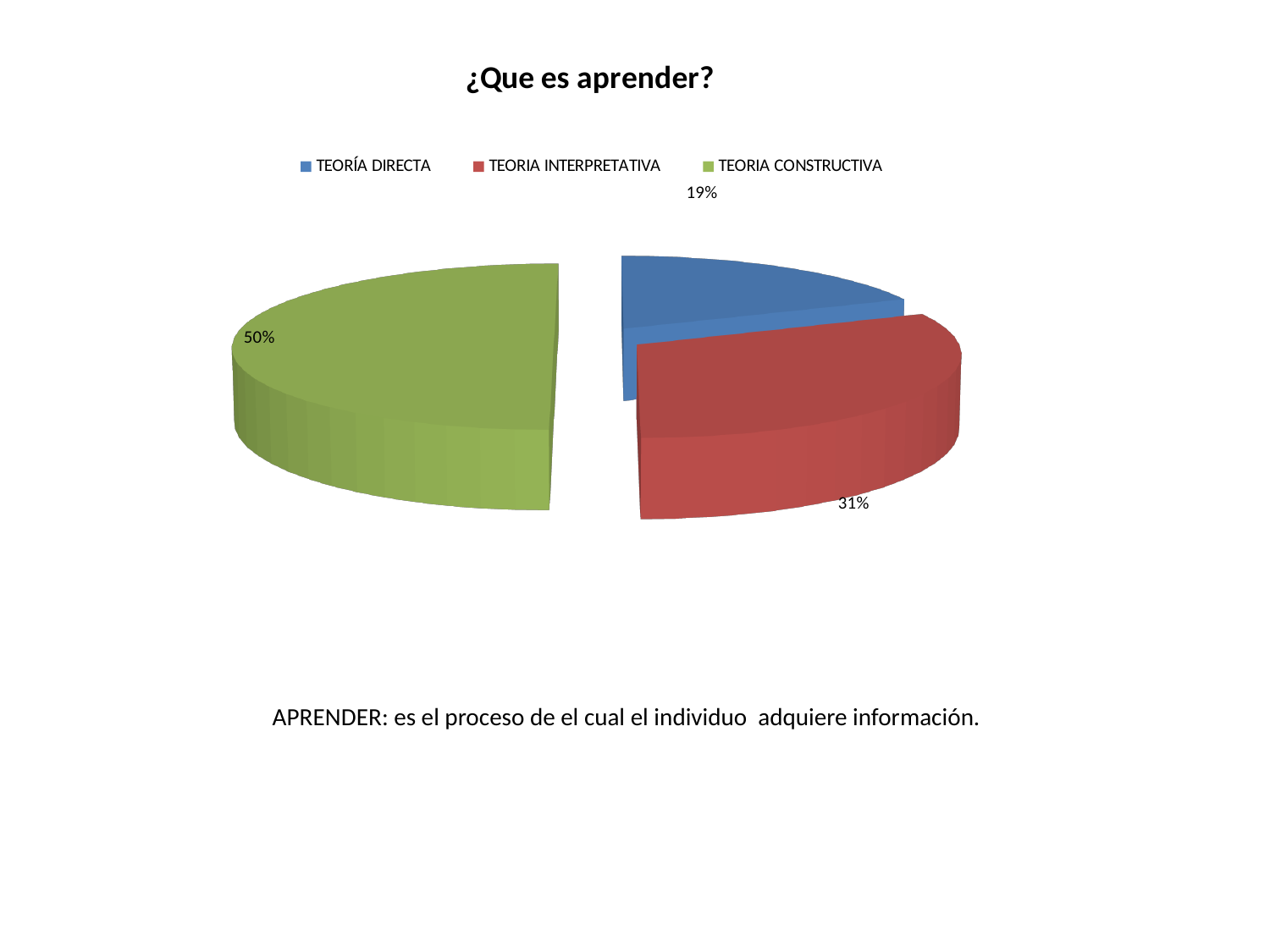
What percentage is shown for TEORIA CONSTRUCTIVA? 50% What is the title of the chart? ¿Que es aprender? How many categories does the pie chart have? 3 Which category has the largest share of the pie? TEORIA CONSTRUCTIVA Which category has the smallest share of the pie? TEORÍA DIRECTA What kind of chart is shown on the slide? Pie chart Which is larger, the share for TEORIA INTERPRETATIVA or the share for TEORÍA DIRECTA? TEORIA INTERPRETATIVA What percentage is shown for TEORÍA DIRECTA? 19% What is the difference in percentage points between TEORIA INTERPRETATIVA and TEORÍA DIRECTA? 12 What colour is the slice for TEORIA CONSTRUCTIVA? Green What percentage is shown for TEORIA INTERPRETATIVA? 31% What is the difference in percentage points between TEORIA CONSTRUCTIVA and TEORIA INTERPRETATIVA? 19